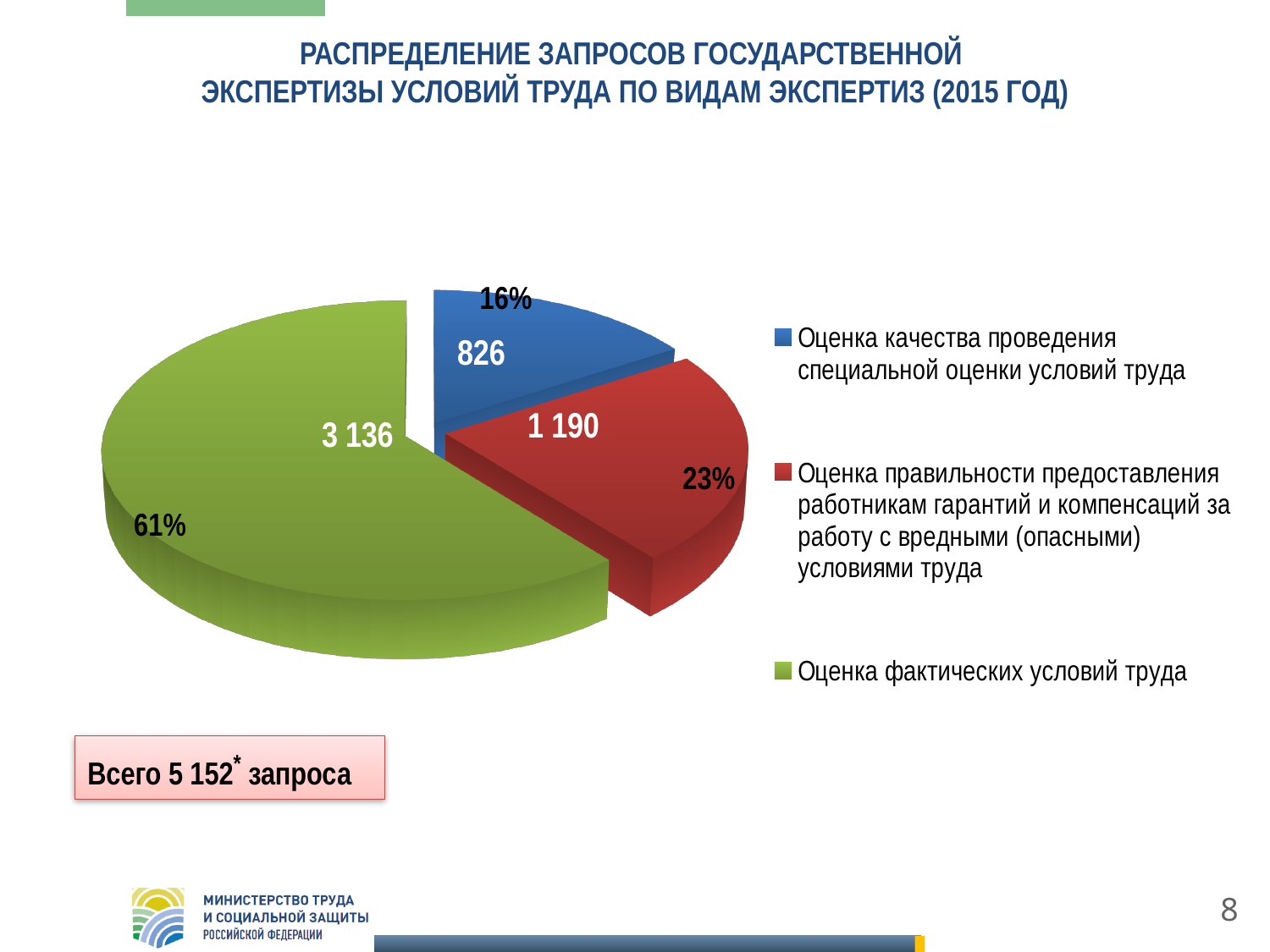
What kind of chart is shown on the slide? pie chart What is the difference between the values for "Оценка правильности предоставления работникам гарантий и компенсаций..." and "Оценка качества проведения специальной оценки условий труда"? 364 What share of the pie does "Оценка фактических условий труда" represent? 61% Which category has the largest slice? Оценка фактических условий труда What colour is the slice for "Оценка фактических условий труда"? green How many slices does the pie chart have? 3 What is the value for "Оценка качества проведения специальной оценки условий труда"? 826 What is the value for "Оценка правильности предоставления работникам гарантий и компенсаций за работу с вредными (опасными) условиями труда"? 1 190 How many entries does the legend list? 3 Which category has the smallest slice? Оценка качества проведения специальной оценки условий труда What is the value for "Оценка фактических условий труда"? 3 136 What share of the pie does "Оценка качества проведения специальной оценки условий труда" represent? 16%